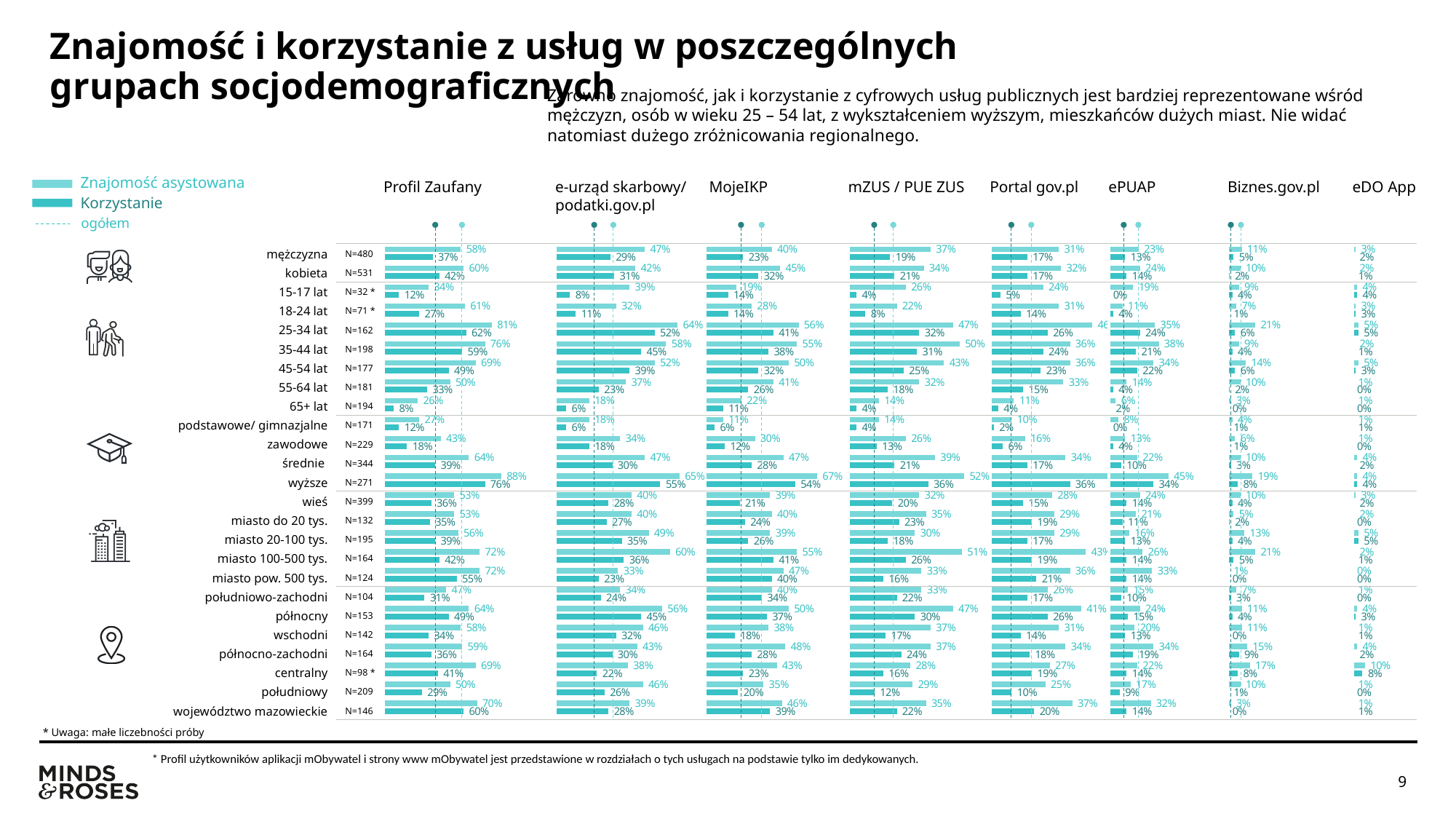
In the Profil Zaufany chart, what is the difference between Znajomość asystowana and Korzystanie for the wyższe group? 12 percentage points In the eDO App chart, what is the Znajomość asystowana value for the centralny region? 10% In the MojeIKP chart, what is the Korzystanie value for the wyższe group? 54% In the Profil Zaufany chart, what is the Korzystanie value for kobieta? 42% What kind of chart is used for each service on the slide? bar chart In the Profil Zaufany chart, which group has the highest Znajomość asystowana value? wyższe In the Portal gov.pl chart, what is the Korzystanie value for the wyższe group? 36% In the e-urząd skarbowy/podatki.gov.pl chart, what is the Znajomość asystowana value for mężczyzna? 47% In the Profil Zaufany chart, what is the Znajomość asystowana value for the wyższe group? 88% How many demographic groups (rows) are plotted in each chart? 25 In the Profil Zaufany chart, which group has the lowest Korzystanie value? 65+ lat In the Profil Zaufany chart, which has the higher Korzystanie value, mężczyzna or kobieta? kobieta